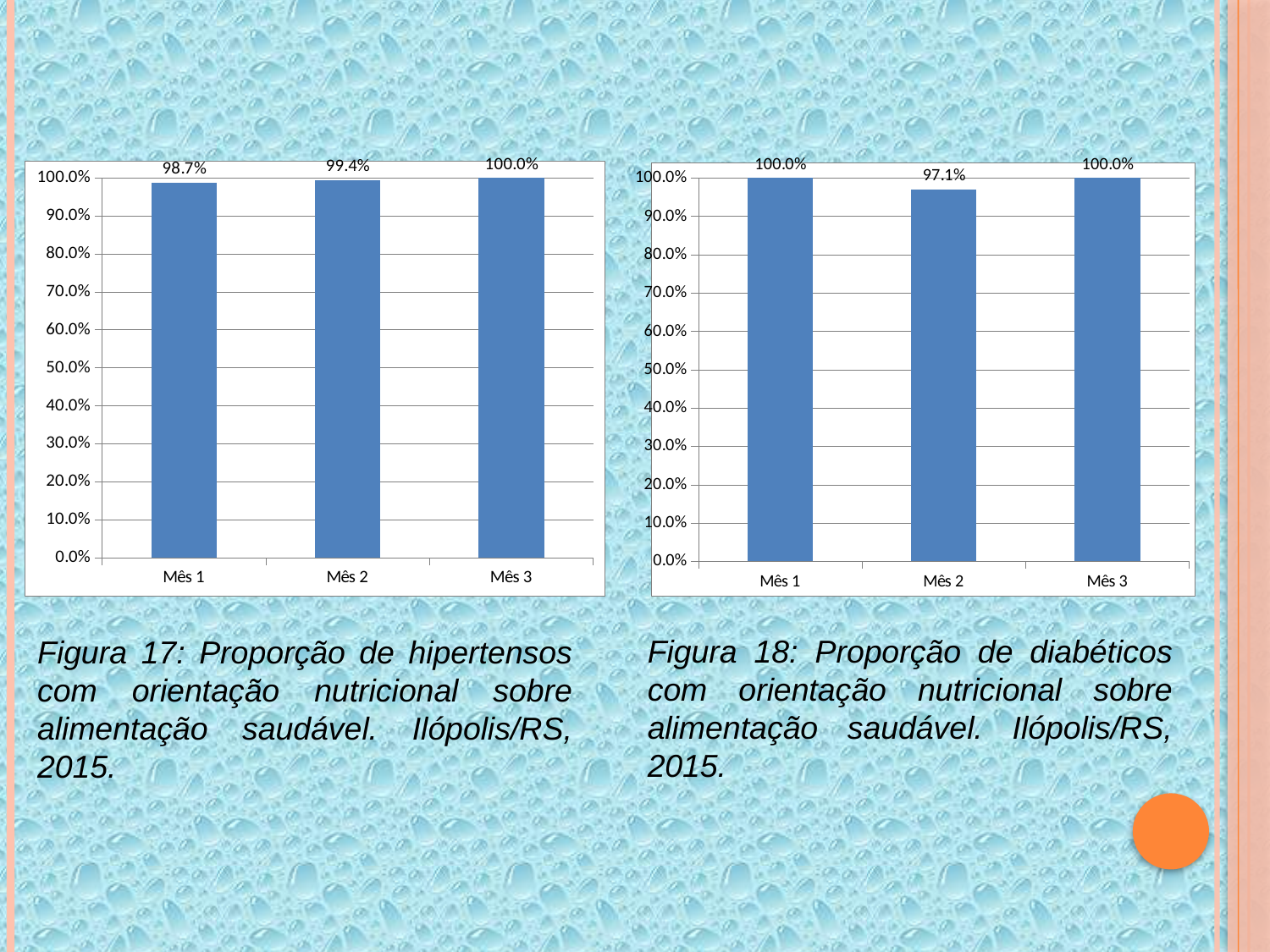
In the right chart (Figura 18), which month has the lowest value? Mês 2 In the left chart (Figura 17), what is the difference between the values for Mês 3 and Mês 1? 1.3% In the right chart (Figura 18), what is the value for Mês 2? 97.1% In the left chart (Figura 17), which month has the lowest value? Mês 1 In the right chart (Figura 18), what is the difference between the values for Mês 1 and Mês 2? 2.9% In the right chart (Figura 18), what is the value for Mês 3? 100.0% How many months are shown in the left chart (Figura 17)? 3 In the right chart (Figura 18), which is larger, the value for Mês 1 or Mês 2? Mês 1 In the left chart (Figura 17), what is the value for Mês 2? 99.4% What kind of chart is the right chart (Figura 18)? Bar chart In the left chart (Figura 17), do the values rise or fall from Mês 1 to Mês 3? Rise In the left chart (Figura 17), what is the value for Mês 1? 98.7%